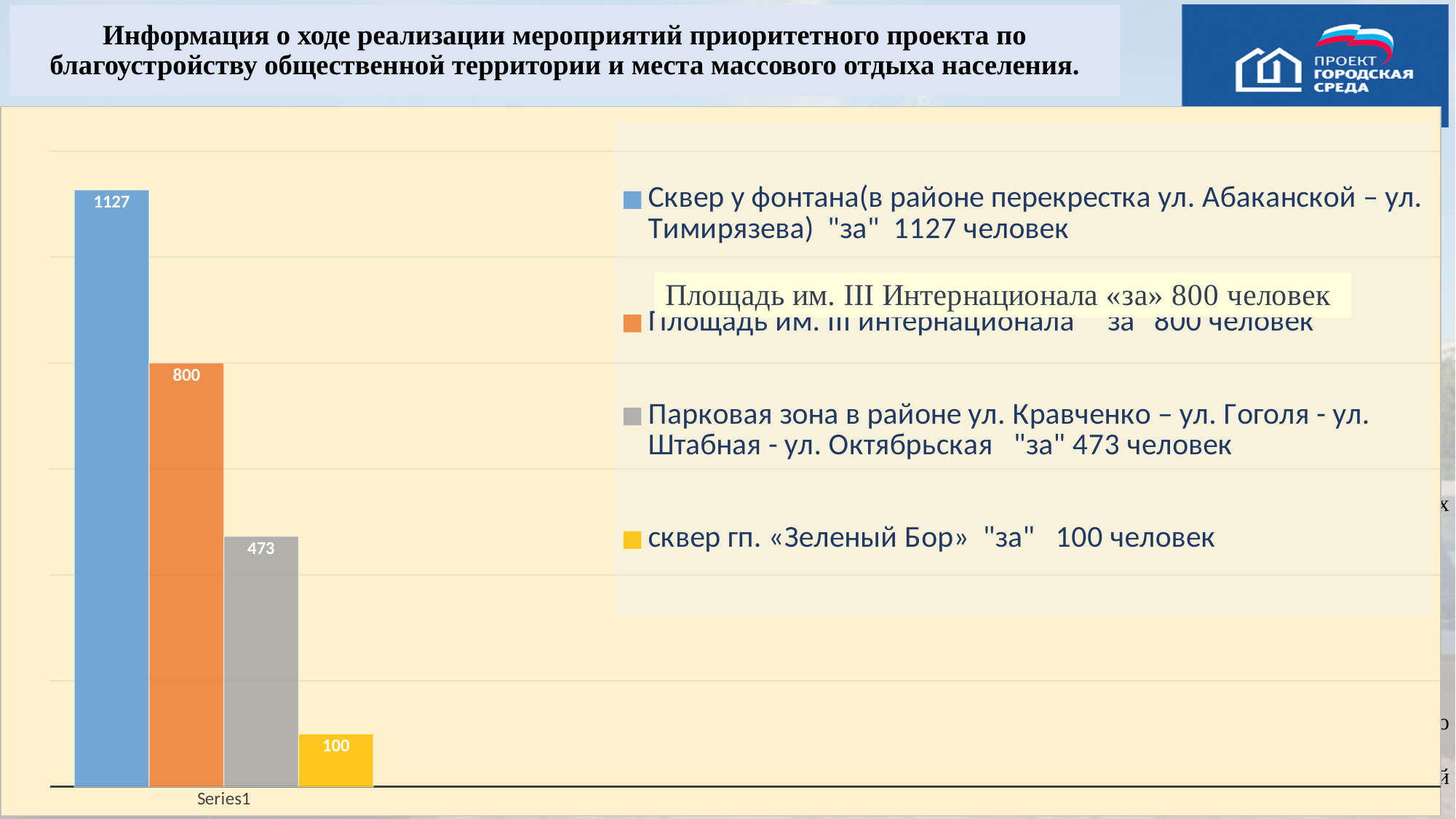
What value is shown on the gray bar for Парковая зона в районе ул. Кравченко – ул. Гоголя - ул. Штабная - ул. Октябрьская? 473 What value is shown on the yellow bar for сквер гп. «Зеленый Бор»? 100 Which legend entry has the highest value in the chart? Сквер у фонтана What is the difference between the values for Сквер у фонтана and Площадь им. III Интернационала? 327 What kind of chart is shown on the slide? bar chart Which is larger: the value for Парковая зона or the value for сквер гп. «Зеленый Бор»? Парковая зона How many bars are plotted in the chart? 4 How many entries does the chart legend list? 4 Which legend entry has the lowest value in the chart? сквер гп. «Зеленый Бор» What value is shown on the blue bar for Сквер у фонтана? 1127 What value is shown on the orange bar for Площадь им. III Интернационала? 800 What label is shown on the horizontal axis below the bars? Series1